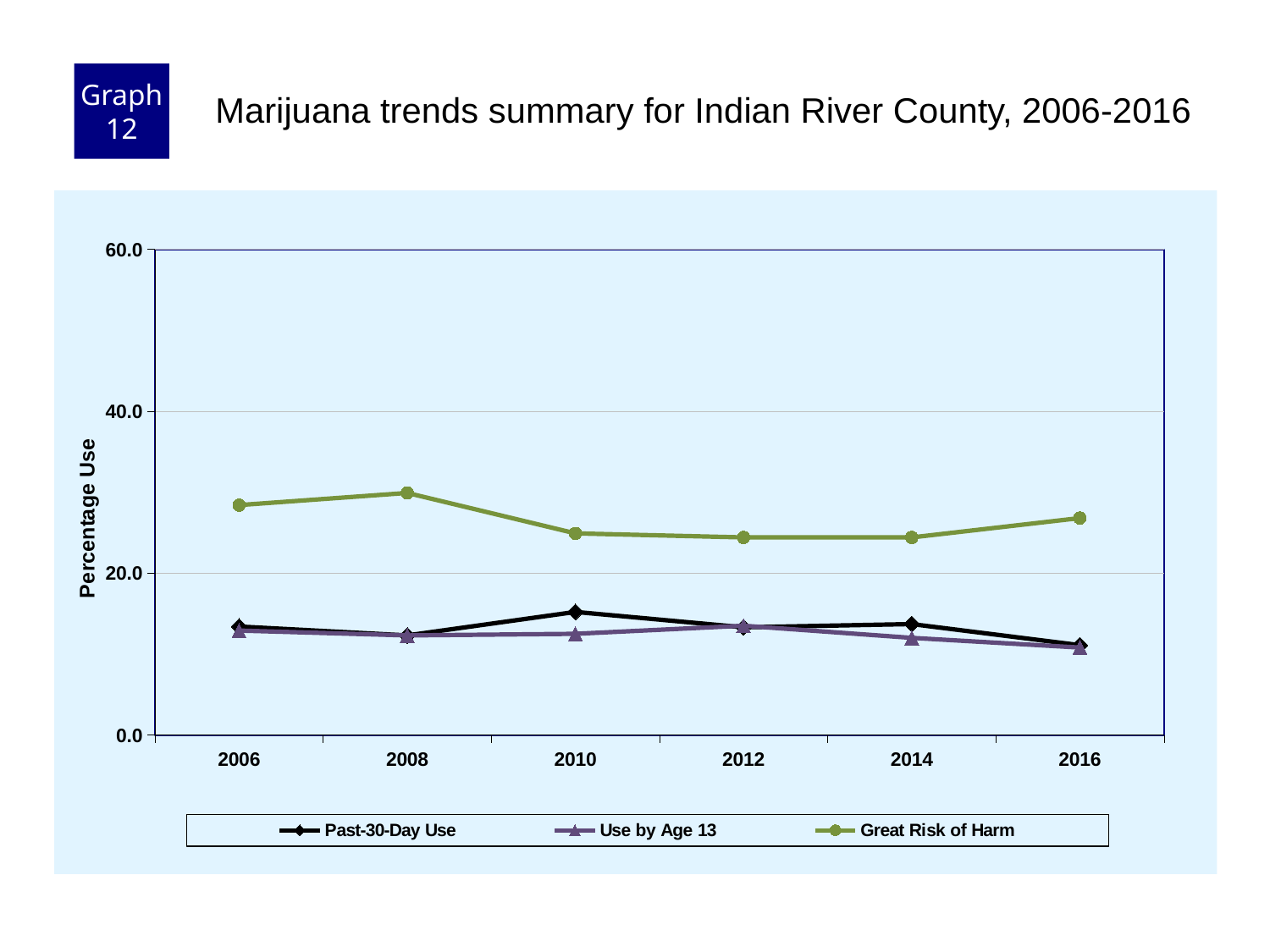
Is the value for Past-30-Day Use in 2010 greater or less than 20.0? less In which year is Past-30-Day Use at its highest? 2010 How many series does the legend list? 3 Is the value for Great Risk of Harm in 2008 greater or less than 20.0? greater How many years are plotted along the x axis? 6 In which year is Great Risk of Harm at its highest? 2008 Does Great Risk of Harm rise or fall from 2008 to 2012? Fall Is the value for Great Risk of Harm in 2006 greater or less than 40.0? less What kind of chart is shown on the slide? Line chart What is the label on the y axis? Percentage Use In 2010, which is larger: Great Risk of Harm or Past-30-Day Use? Great Risk of Harm In which year is Past-30-Day Use at its lowest? 2016